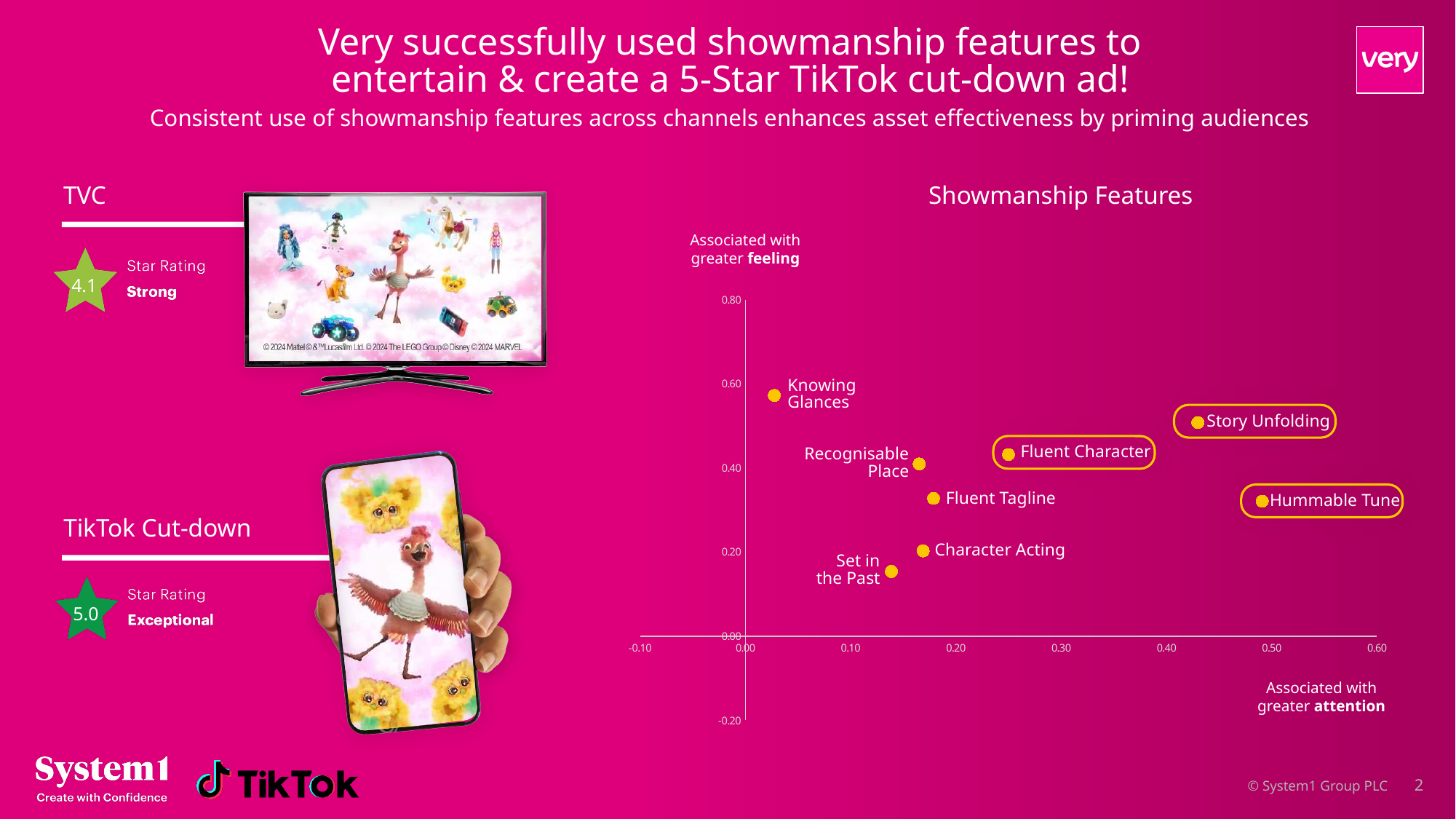
Which showmanship feature is plotted furthest right on the horizontal (attention) axis? Hummable Tune Which three showmanship features are highlighted with a yellow outline on the chart? Story Unfolding, Fluent Character, Hummable Tune Is the horizontal-axis value for Hummable Tune greater or less than 0.40? greater Which showmanship feature is plotted highest on the vertical (feeling) axis? Knowing Glances How many showmanship features are plotted on the Showmanship Features chart? 8 Which is plotted higher on the vertical (feeling) axis, Story Unfolding or Fluent Character? Story Unfolding What is the title of the scatter chart on the slide? Showmanship Features Which showmanship feature is plotted lowest on the vertical (feeling) axis? Set in the Past Which showmanship feature is plotted furthest left on the horizontal (attention) axis? Knowing Glances Is the vertical-axis value for Knowing Glances greater or less than 0.40? greater Is the vertical-axis value for Fluent Tagline greater or less than 0.40? less What kind of chart is the Showmanship Features chart? scatter chart